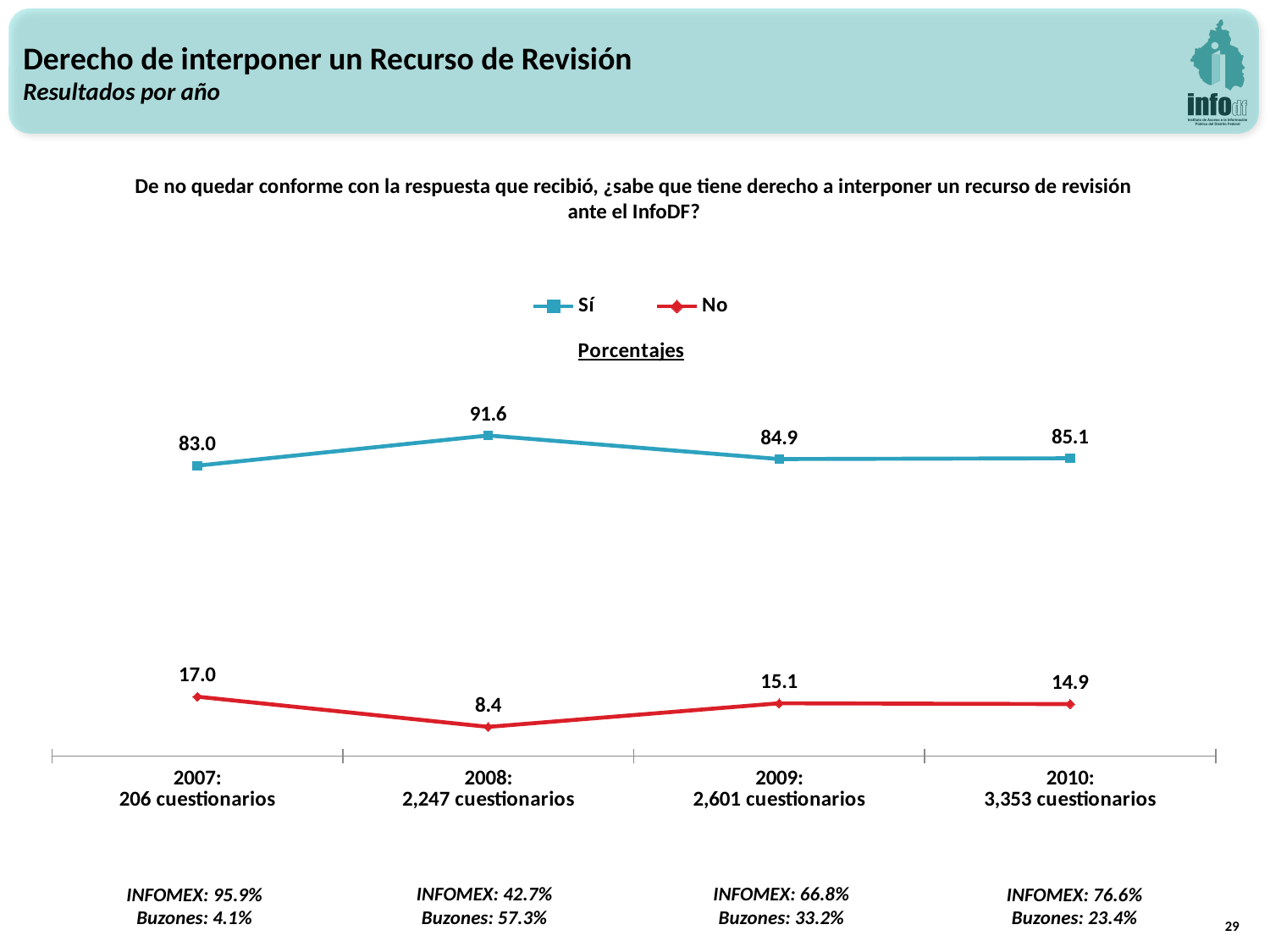
What percentage answered "No" in 2007? 17.0 How many series does the legend list? 2 What percentage answered "Sí" in 2008? 91.6 How many years are shown on the x axis? 4 In which year was the "Sí" percentage highest? 2008 Which is larger, the "No" value for 2007 or for 2010? 2007 What is the value of the "No" series for 2009? 15.1 What type of chart is shown on the slide? Line chart What is the difference between the "Sí" values for 2008 and 2007? 8.6 In which year was the "No" percentage lowest? 2008 How many questionnaires (cuestionarios) were there in 2009 according to the x-axis label? 2,601 What is the value of the "Sí" series for 2010? 85.1